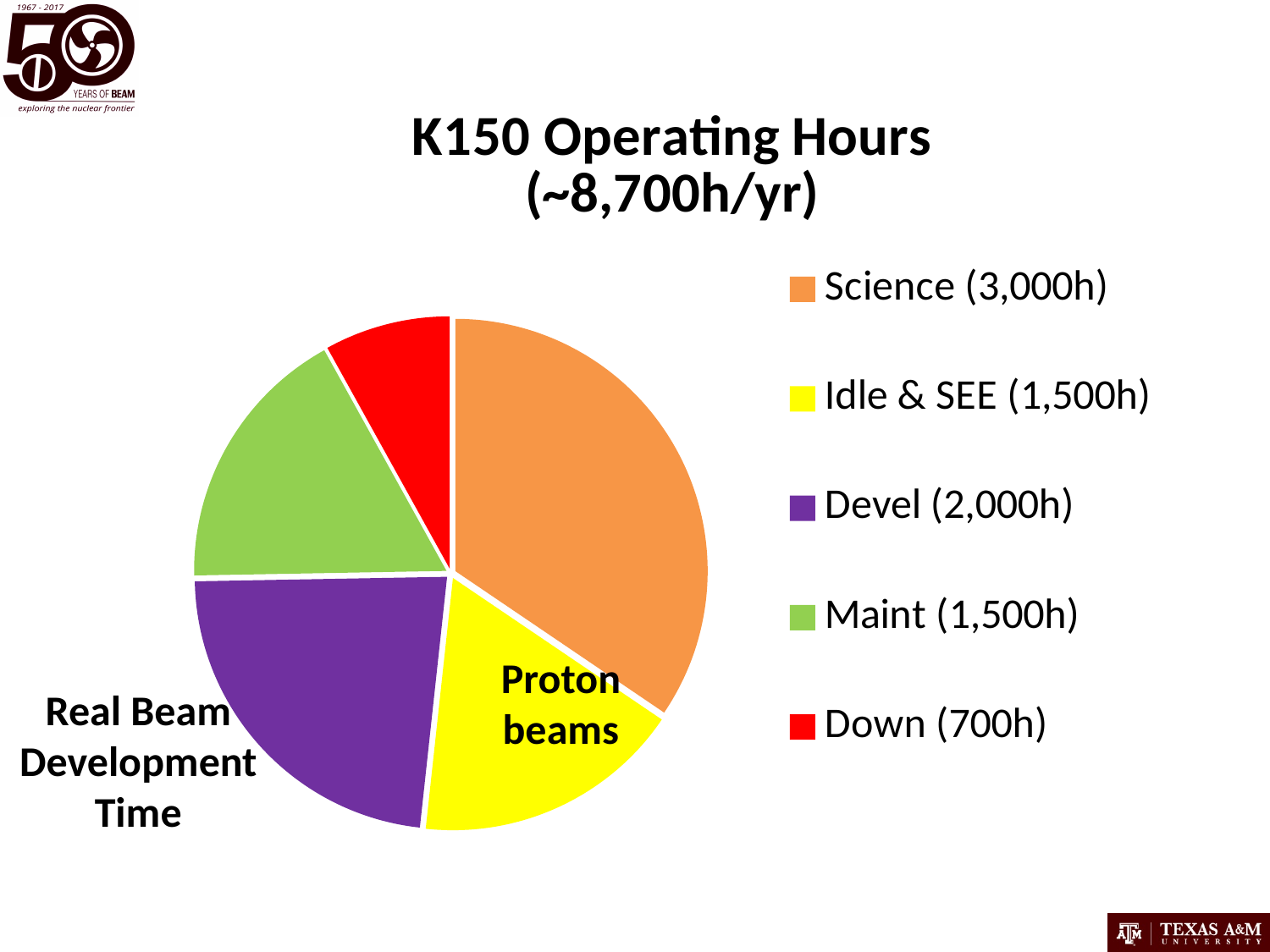
How many hours are shown for Devel in the legend? 2,000h What colour is the Science slice of the pie? orange What is the title of the chart? K150 Operating Hours (~8,700h/yr) Which has more hours, Devel or Maint? Devel What kind of chart is shown on the slide? pie chart Which category has the smallest number of hours? Down How many slices does the pie chart have? 5 How many hours are shown for Down in the legend? 700h How many hours are shown for Idle & SEE in the legend? 1,500h What is the difference in hours between Science and Devel? 1,000h How many hours are shown for Science in the legend? 3,000h Which category has the largest number of hours? Science